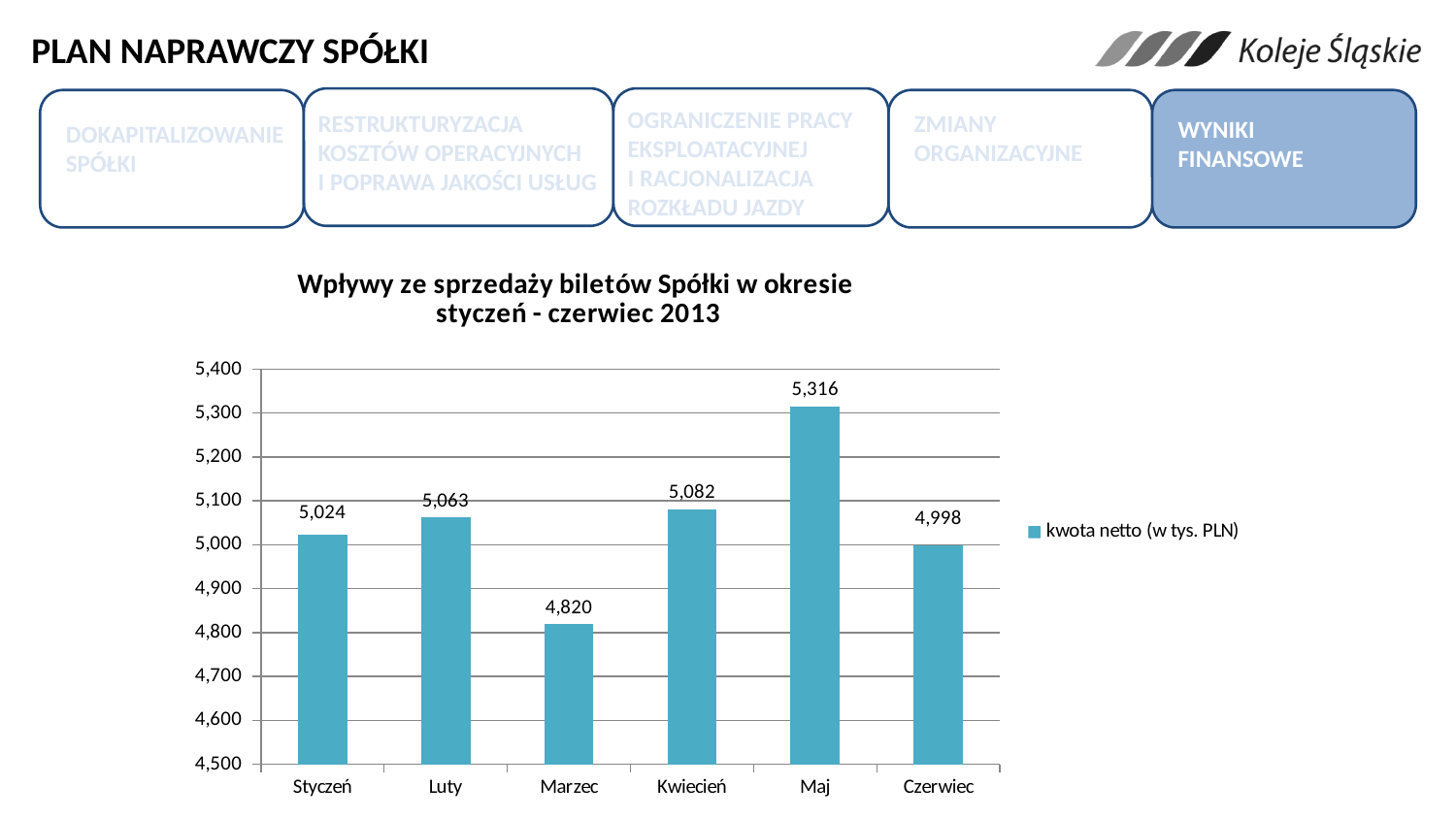
Is the value for Czerwiec greater or less than 5,000? less What is the difference between the values for Maj and Marzec? 496 Which month has the lowest value? Marzec How many months are shown on the x axis? 6 Which is larger, the value for Kwiecień or the value for Luty? Kwiecień Which month has the highest value? Maj What is the value for Maj? 5,316 What is the value for Czerwiec? 4,998 What kind of chart is shown on the slide? bar chart What is the difference between the values for Luty and Styczeń? 39 What is the value for Marzec? 4,820 What is the legend entry for the series shown in the chart? kwota netto (w tys. PLN)